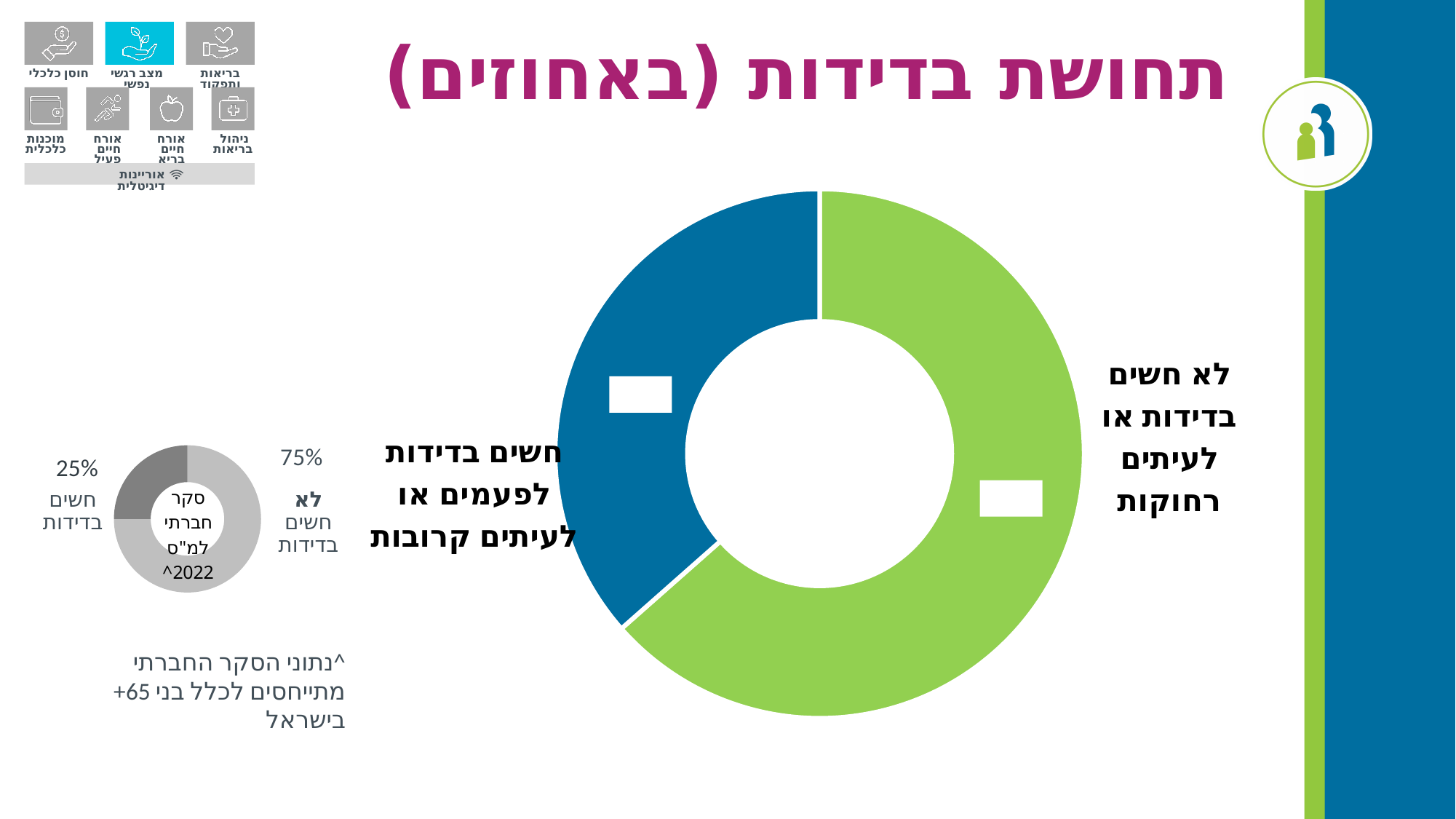
In the small donut chart on the left (סקר חברתי למ"ס 2022), what is the value for 'חשים בדידות'? 25% In the small donut chart on the left, what is the difference between 'לא חשים בדידות' and 'חשים בדידות'? 50% In the large donut chart, what colour is the slice for 'חשים בדידות לפעמים או לעיתים קרובות'? Blue In the small donut chart on the left, which category has the highest share? לא חשים בדידות In the small donut chart on the left, which category has the lowest share? חשים בדידות In the large donut chart, how many slices are shown? 2 In the small donut chart on the left, how many categories are shown? 2 In the small donut chart on the left (סקר חברתי למ"ס 2022), what is the value for 'לא חשים בדידות'? 75% What is the label written in the centre of the small donut chart on the left? סקר חברתי למ"ס 2022^ In the small donut chart on the left, is the value for 'חשים בדידות' greater or less than 50%? less In the large donut chart, which category has the larger share: 'לא חשים בדידות או לעיתים רחוקות' or 'חשים בדידות לפעמים או לעיתים קרובות'? לא חשים בדידות או לעיתים רחוקות What kind of chart is the large chart in the centre of the slide? Donut (pie) chart